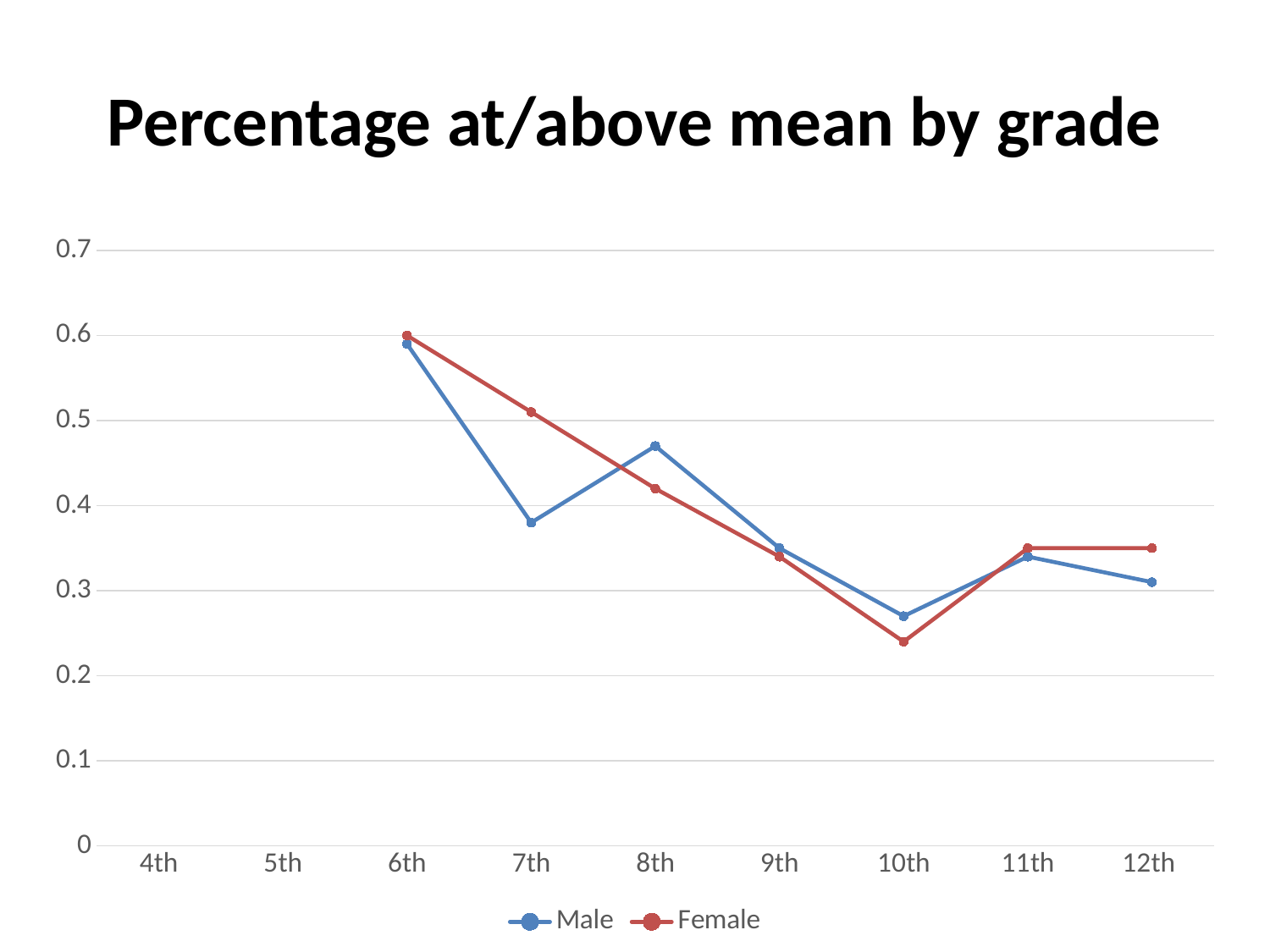
At 7th grade, which series has the larger value, Male or Female? Female Is the Female value for 10th grade greater or less than 0.3? less What kind of chart is shown on the slide? line chart Does the Female series rise or fall from 6th grade to 10th grade? fall At which grade is the Male series lowest? 10th Is the Male value for 8th grade greater or less than 0.4? greater How many series does the legend list? 2 At which grade is the Female series highest? 6th What is the Female value for 6th grade? 0.6 Is the Male value for 7th grade greater or less than 0.4? less What is the title of the chart? Percentage at/above mean by grade How many grade categories are shown on the x axis? 9